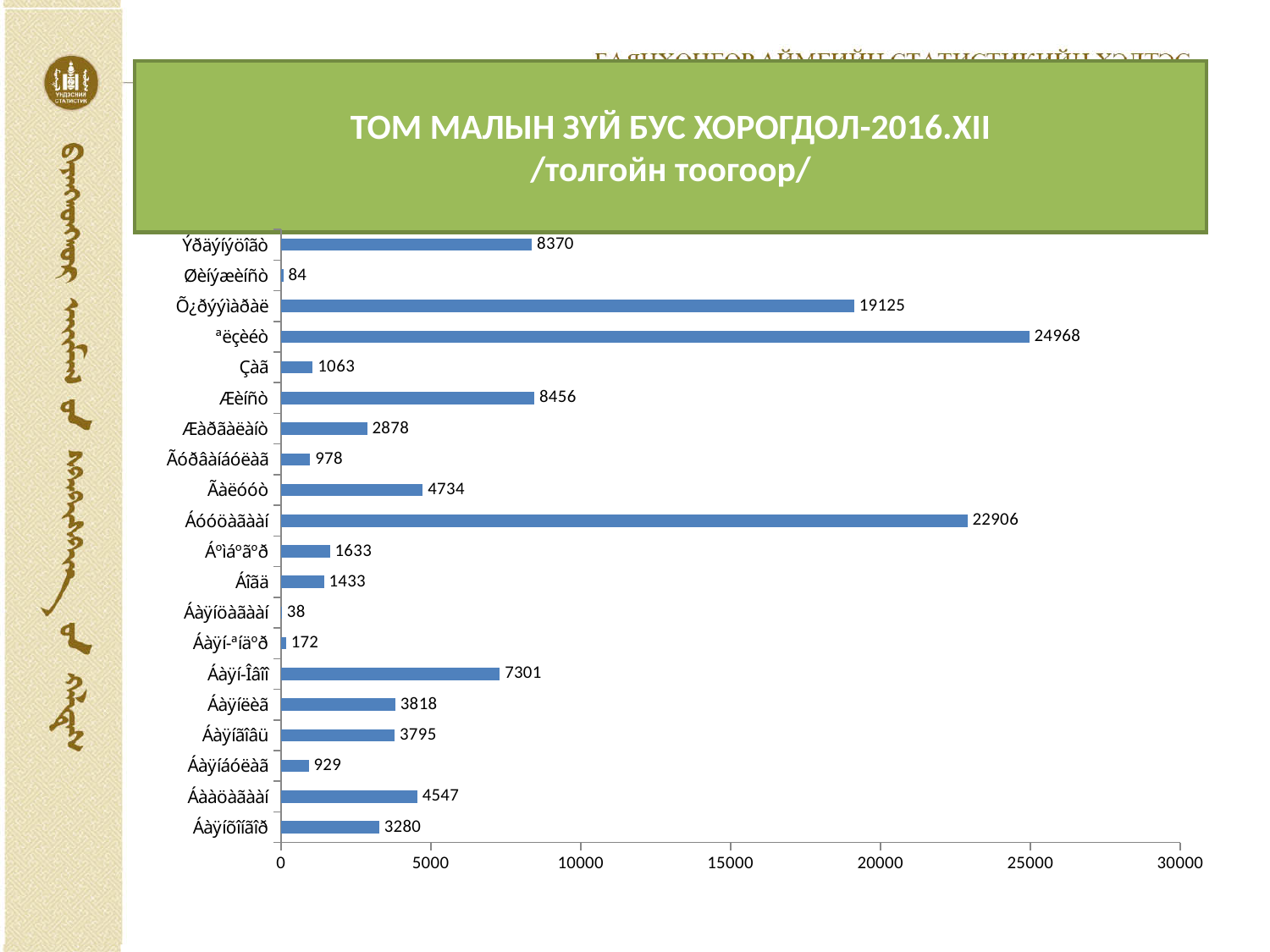
What is the largest value shown on the chart? 24968 What is the value of the topmost bar on the chart? 8370 What is the difference between the largest value (24968) and the second largest value (22906) on the chart? 2062 What is the value of the bottommost bar on the chart? 3280 What is the highest tick value shown on the horizontal axis? 30000 What is the smallest value shown on the chart? 38 How many categories (bars) does the chart show? 20 Is the value of the third bar from the top greater or less than 15000? greater What is the value of the fourth bar from the top? 24968 What is the first line of the chart's title? ТОМ МАЛЫН ЗҮЙ БУС ХОРОГДОЛ-2016.XII What kind of chart is shown on the slide? bar chart Which is larger: the topmost bar (8370) or the bottommost bar (3280)? the topmost bar (8370)